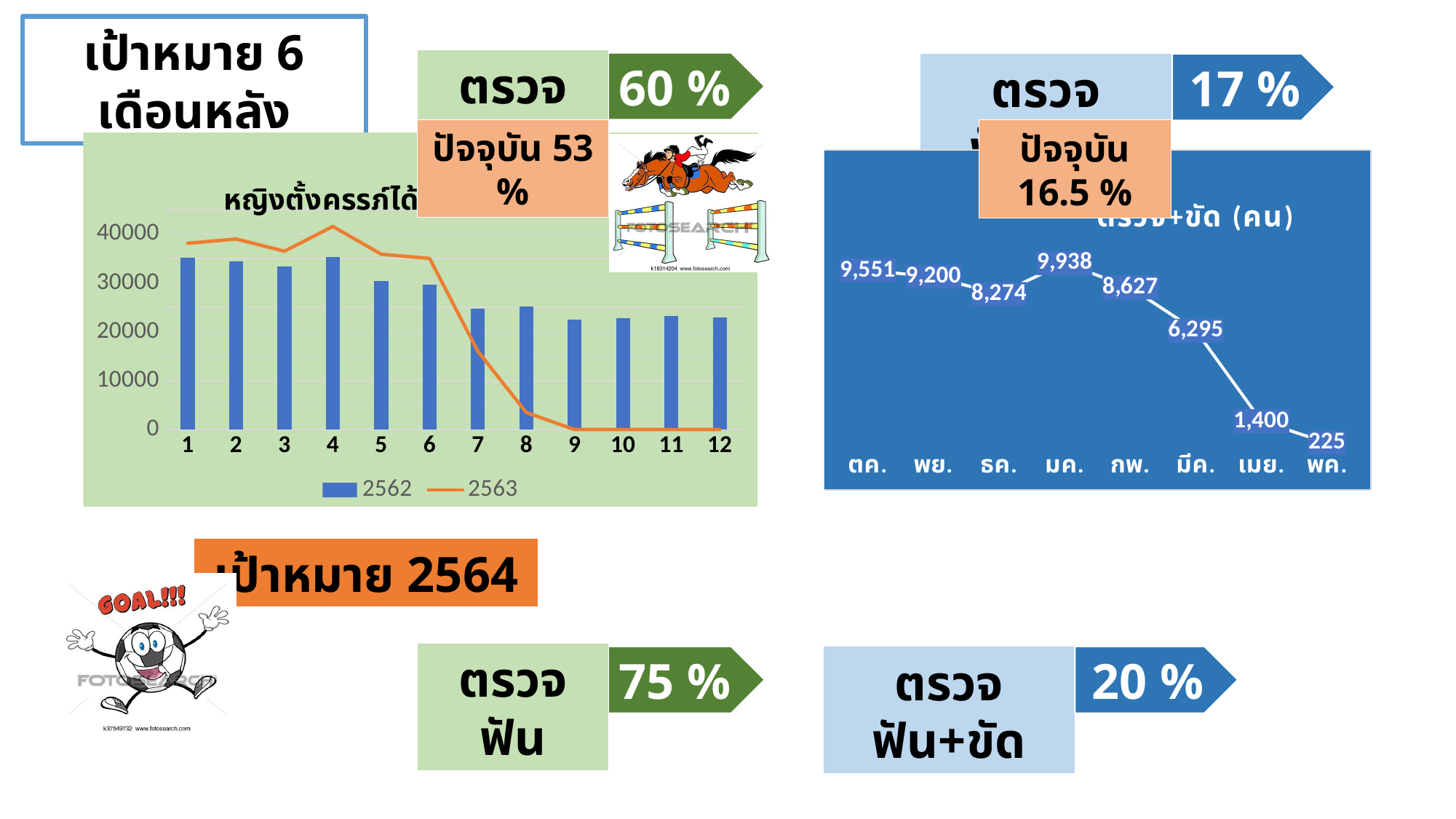
In the chart on the right (ตรวจ+ขัด (คน)), what is the difference between the values for เมย. and พค.? 1,175 In the chart on the right (ตรวจ+ขัด (คน)), what is the value for มีค.? 6,295 In the chart on the right (ตรวจ+ขัด (คน)), do the values generally rise or fall from ตค. to พค.? fall In the chart on the left (green background), how many series does the legend list? 2 In the chart on the right (ตรวจ+ขัด (คน)), which month has the highest value? มค. In the chart on the left (green background), is the 2562 bar for category 1 greater or less than 30000? greater In the chart on the right (ตรวจ+ขัด (คน)), which is larger, the value for พย. or the value for ธค.? พย. What kind of chart is the chart on the right (ตรวจ+ขัด (คน))? line chart In the chart on the right (ตรวจ+ขัด (คน)), which month has the lowest value? พค. In the chart on the right (ตรวจ+ขัด (คน)), what is the value for ตค.? 9,551 In the chart on the right (ตรวจ+ขัด (คน)), how many months are plotted? 8 In the chart on the left (green background), is the 2563 line value for category 8 greater or less than 10000? less